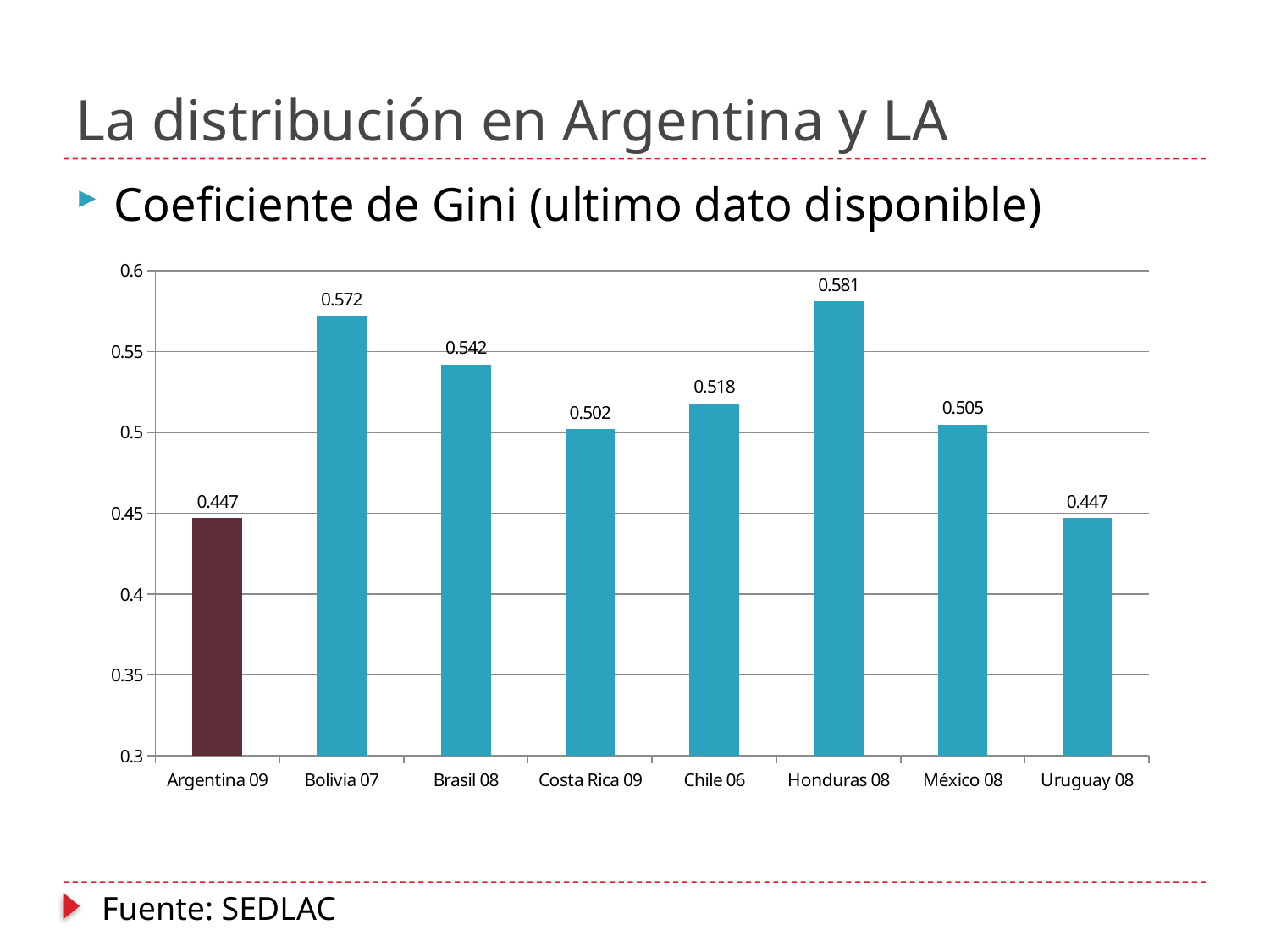
What is the difference between the values for Honduras 08 and Argentina 09? 0.134 Which country has the highest Gini coefficient in the chart? Honduras 08 What is the difference between the values for Bolivia 07 and Brasil 08? 0.030 Which country's bar is shown in a different colour from the others? Argentina 09 What value is shown for Argentina 09? 0.447 What is the Gini coefficient shown for Honduras 08? 0.581 Is the value for Uruguay 08 greater or less than 0.5? less What kind of chart is shown on the slide? bar chart Which has a higher value, México 08 or Bolivia 07? Bolivia 07 What is the value for Chile 06? 0.518 How many countries are shown in the chart? 8 What value is shown for Brasil 08? 0.542